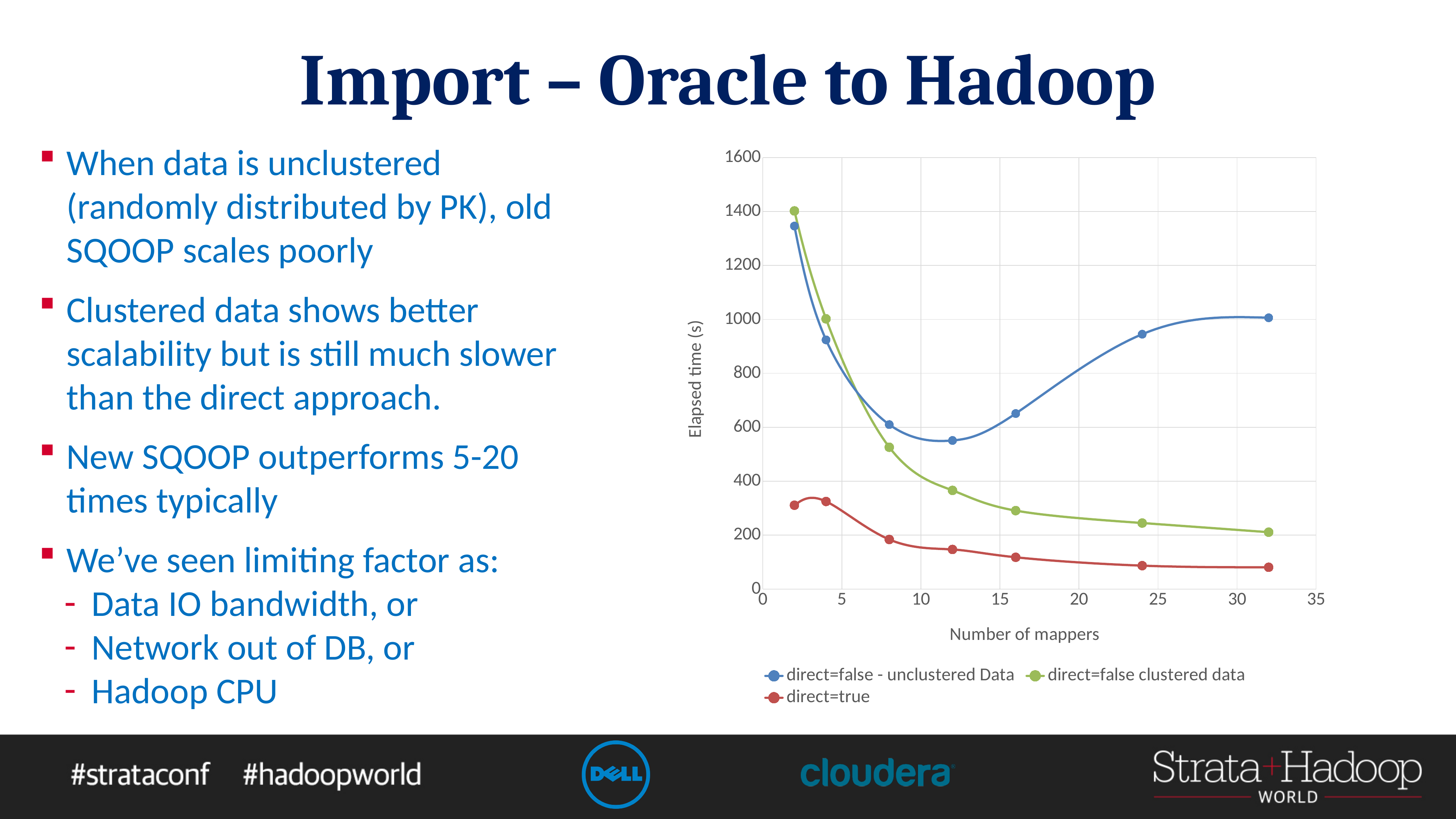
What is the label of the y axis? Elapsed time (s) How many series does the chart legend list? 3 Is the elapsed time for direct=false clustered data at 8 mappers greater or less than 400? greater What is the label of the x axis? Number of mappers Is the elapsed time for direct=false clustered data at 32 mappers greater or less than 400? less Which series has the lowest elapsed time at 16 mappers? direct=true Is the elapsed time for direct=true at 2 mappers greater or less than 400? less How many data points are plotted for the direct=true series? 7 Does the elapsed time for direct=false clustered data rise or fall as the number of mappers increases? fall What kind of chart is shown on the slide? line chart At 32 mappers, which series has the higher elapsed time: direct=false - unclustered Data or direct=false clustered data? direct=false - unclustered Data